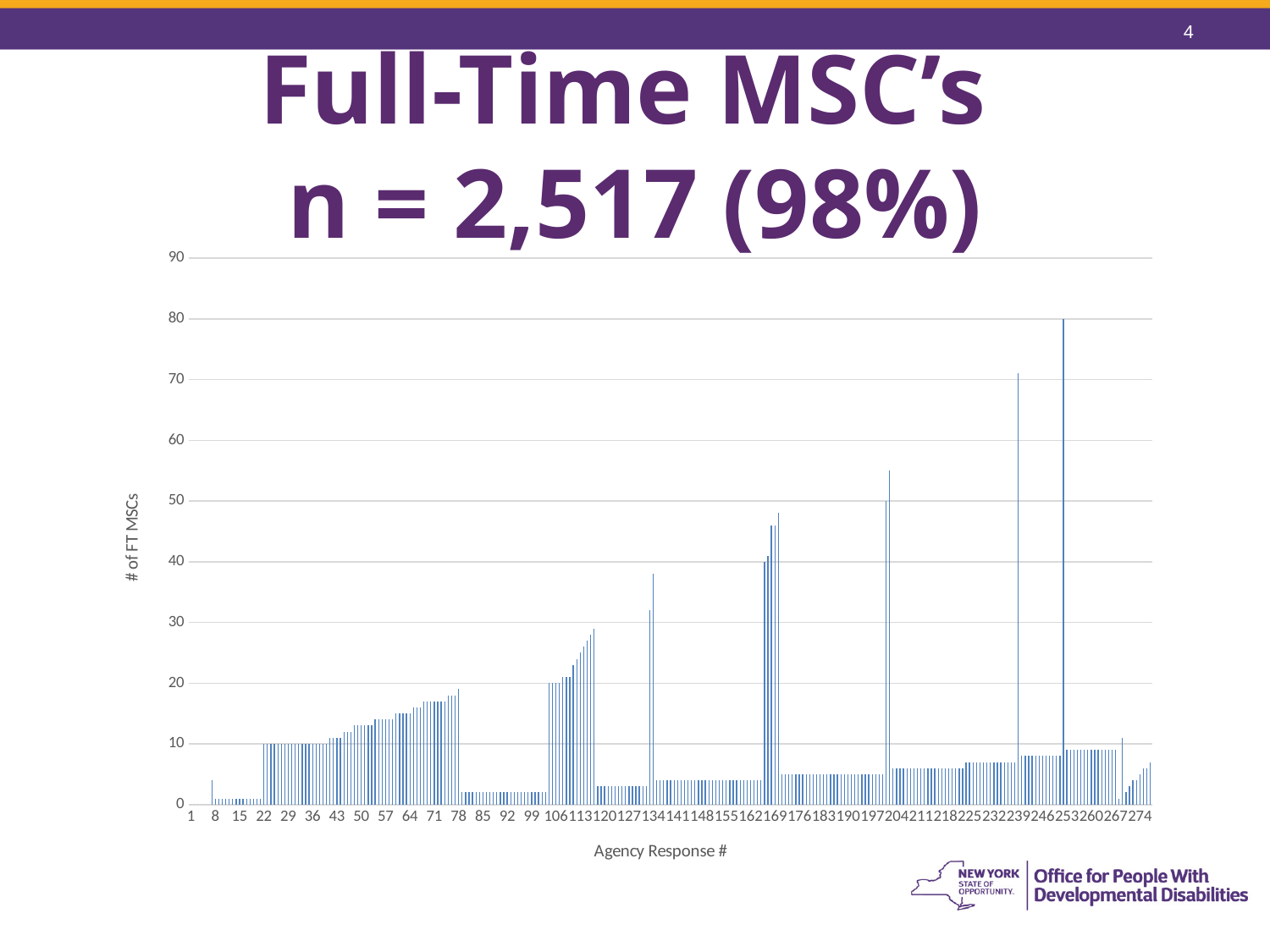
Is the value of the tallest bar in the chart greater or less than 90? less What type of chart is shown on the slide? bar chart Is the value for Agency Response 8 greater or less than 10? less Is the value for Agency Response 64 greater or less than 20? less What is the label on the vertical axis of the chart? # of FT MSCs What is the title of the chart? Full-Time MSC's n = 2,517 (98%)